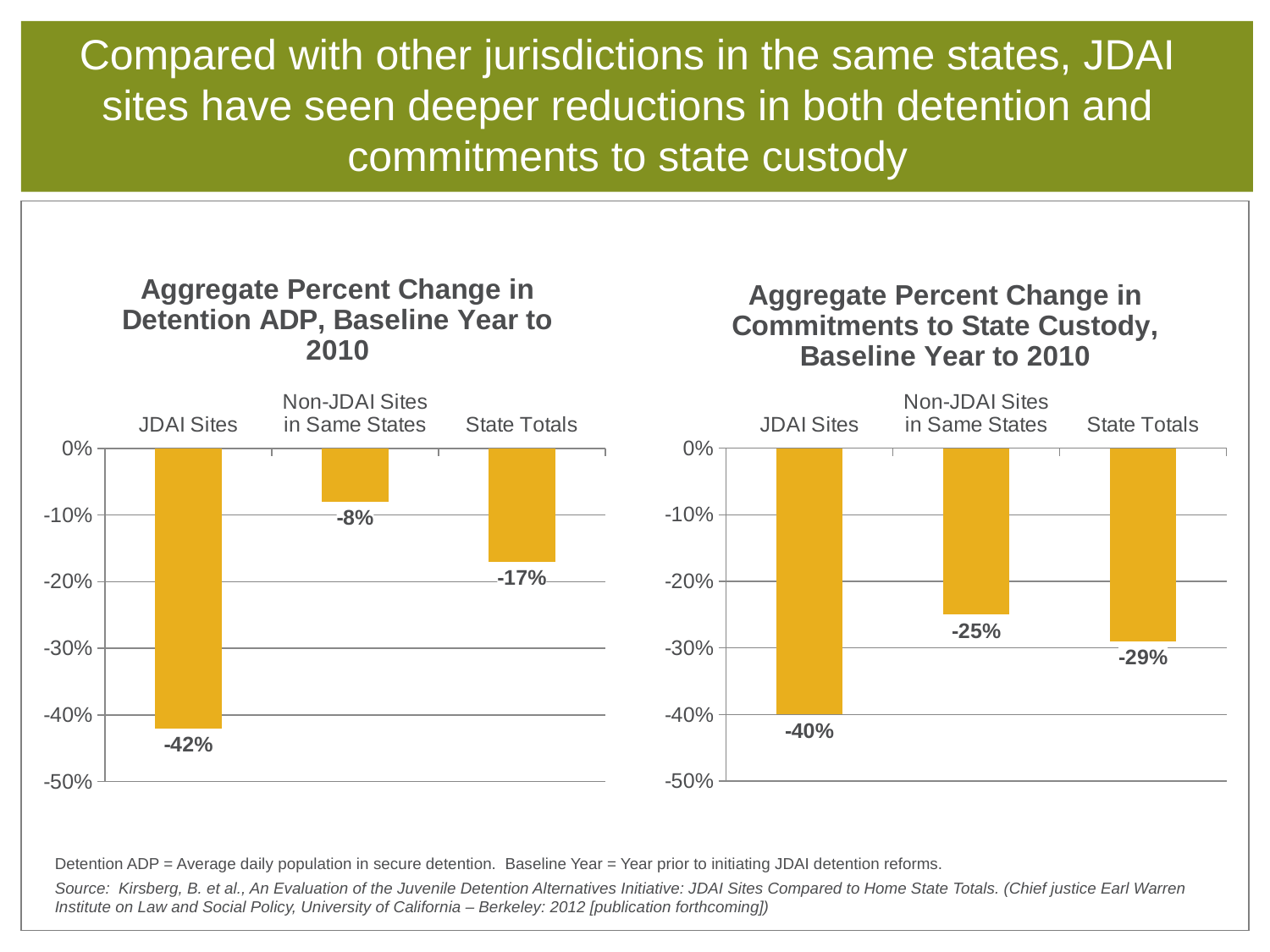
In the right chart (Aggregate Percent Change in Commitments to State Custody), what is the value for State Totals? -29% In the right chart (Aggregate Percent Change in Commitments to State Custody), which shows a larger reduction: Non-JDAI Sites in Same States or State Totals? State Totals In the left chart (Aggregate Percent Change in Detention ADP), what is the value for Non-JDAI Sites in Same States? -8% In the left chart (Aggregate Percent Change in Detention ADP), what is the difference in percentage points between the JDAI Sites value and the State Totals value? 25 percentage points In the left chart (Aggregate Percent Change in Detention ADP), which category shows the largest reduction? JDAI Sites How many categories are shown in the left chart (Aggregate Percent Change in Detention ADP)? 3 In the right chart (Aggregate Percent Change in Commitments to State Custody), what is the value for Non-JDAI Sites in Same States? -25% In the right chart (Aggregate Percent Change in Commitments to State Custody), what is the difference in percentage points between the JDAI Sites value and the Non-JDAI Sites in Same States value? 15 percentage points In the left chart (Aggregate Percent Change in Detention ADP), what is the value for JDAI Sites? -42% In the right chart (Aggregate Percent Change in Commitments to State Custody), which category shows the largest reduction? JDAI Sites What kind of chart is the right chart (Aggregate Percent Change in Commitments to State Custody)? Bar chart In the left chart (Aggregate Percent Change in Detention ADP), which category shows the smallest reduction? Non-JDAI Sites in Same States